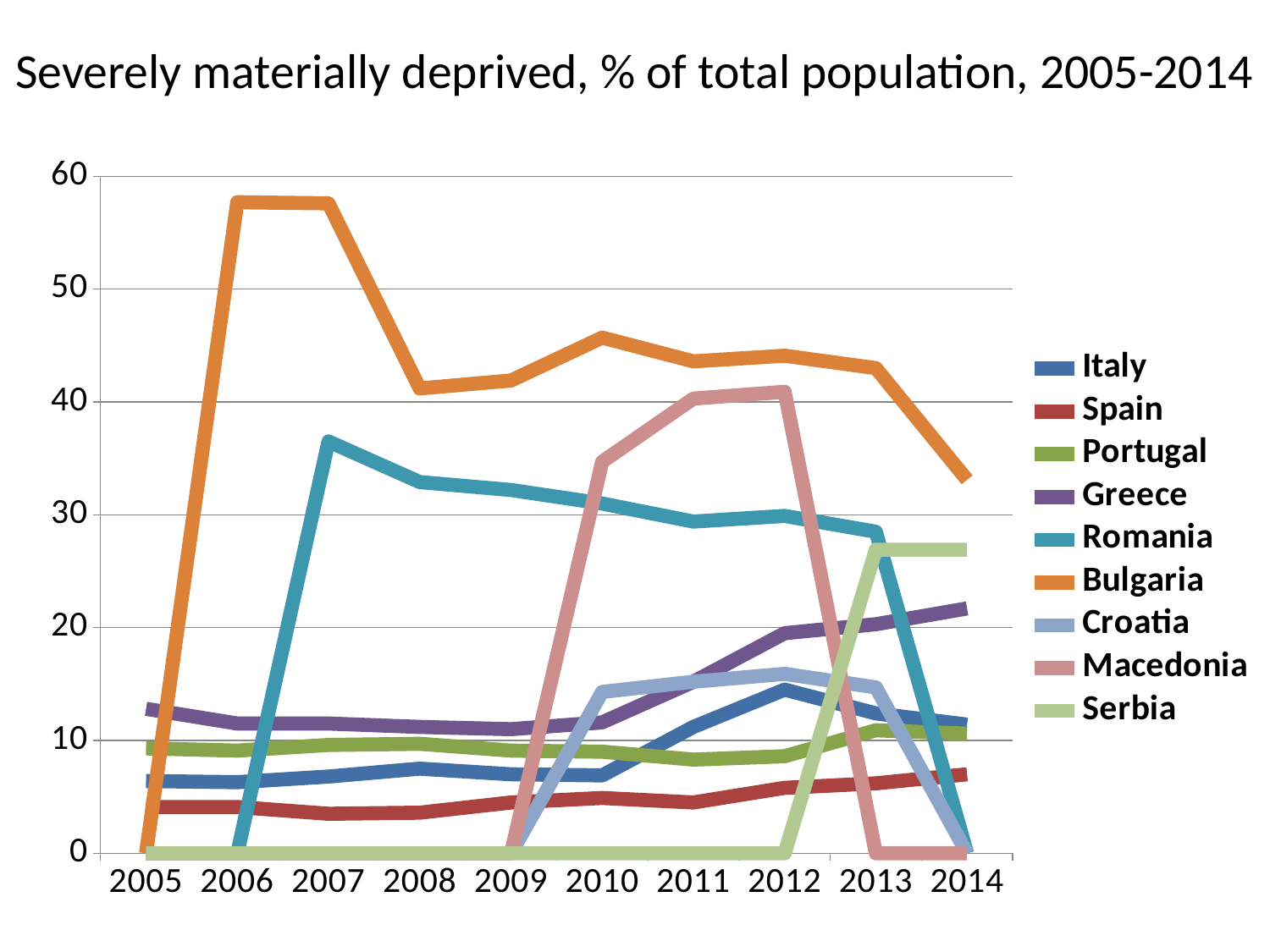
Is the value for Spain in 2005 greater or less than 10? less Is the value for Romania in 2007 greater or less than 30? greater Which country has the highest value in 2007? Bulgaria Is the value for Bulgaria in 2006 greater or less than 50? greater Does the value for Bulgaria rise or fall from 2012 to 2014? fall What kind of chart is shown on the slide? line chart In 2014, which is larger: the value for Greece or the value for Italy? Greece How many series does the legend list? 9 How many years are shown along the x axis? 10 In 2012, which is larger: the value for Macedonia or the value for Romania? Macedonia Which country has the highest value in 2013? Bulgaria